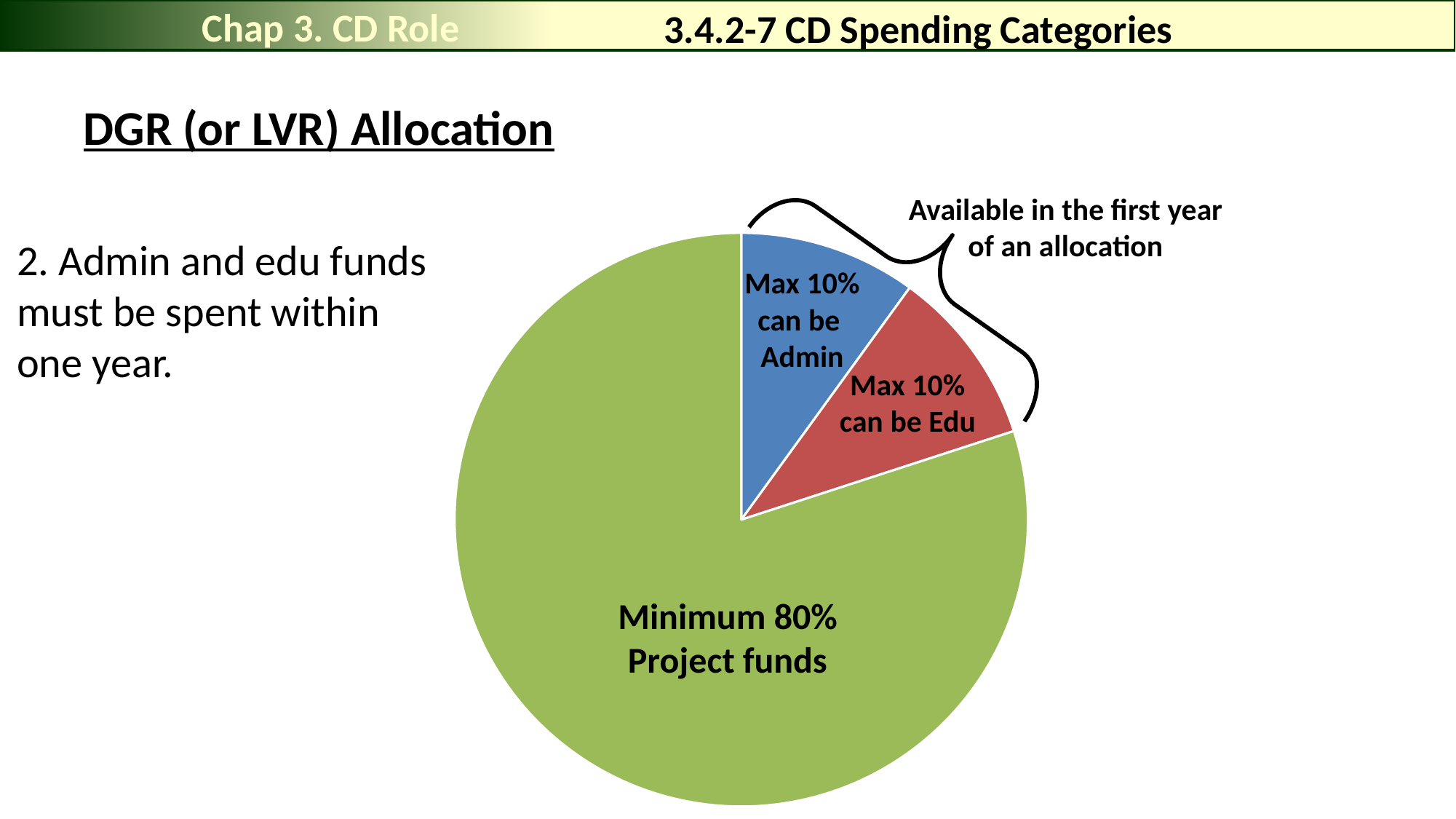
What colour is the Project funds slice in the pie chart? green What share of the allocation is labelled for Project funds in the pie chart? Minimum 80% Which is larger in the pie chart, the Admin slice or the Project funds slice? Project funds What does the annotation next to the Admin and Edu slices say? Available in the first year of an allocation What share of the allocation is labelled for Edu in the pie chart? Max 10% How many slices does the pie chart have? 3 What share of the allocation is labelled for Admin in the pie chart? Max 10% By how many percentage points does the Project funds share (80%) exceed the Admin share (10%)? 70 percentage points What kind of chart is shown on the slide? pie chart Which slice of the pie chart is the largest? Project funds Is the Project funds share in the pie chart greater or less than 50%? greater